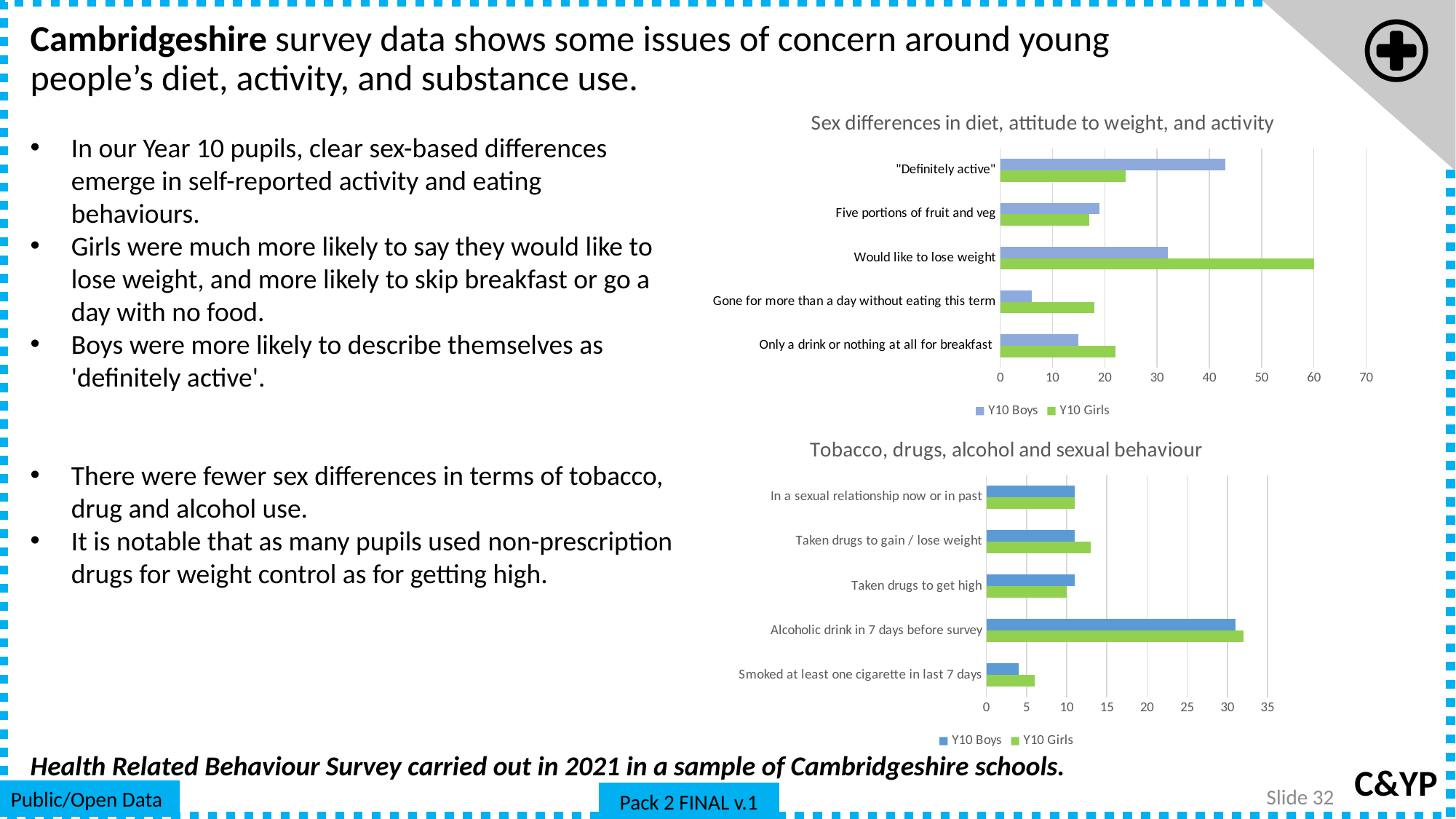
In the 'Tobacco, drugs, alcohol and sexual behaviour' chart, is the Y10 Girls value for 'Alcoholic drink in 7 days before survey' greater or less than 30? greater In the 'Sex differences in diet, attitude to weight, and activity' chart, is the Y10 Girls value for 'Would like to lose weight' greater or less than 50? greater In the 'Tobacco, drugs, alcohol and sexual behaviour' chart, which category has the lowest value for Y10 Boys? Smoked at least one cigarette in last 7 days In the 'Sex differences in diet, attitude to weight, and activity' chart, which category has the highest value for Y10 Girls? Would like to lose weight What kind of chart is the 'Sex differences in diet, attitude to weight, and activity' chart? Bar chart In the 'Sex differences in diet, attitude to weight, and activity' chart, is the Y10 Boys value for 'Gone for more than a day without eating this term' greater or less than 10? less How many series does the legend of the 'Sex differences in diet, attitude to weight, and activity' chart list? 2 How many categories are shown in the 'Tobacco, drugs, alcohol and sexual behaviour' chart? 5 In the 'Sex differences in diet, attitude to weight, and activity' chart, which category has the lowest value for Y10 Boys? Gone for more than a day without eating this term In the 'Tobacco, drugs, alcohol and sexual behaviour' chart, which category has the highest value for Y10 Girls? Alcoholic drink in 7 days before survey In the 'Sex differences in diet, attitude to weight, and activity' chart, which series has the larger value for '"Definitely active"', Y10 Boys or Y10 Girls? Y10 Boys How many categories are shown in the 'Sex differences in diet, attitude to weight, and activity' chart? 5